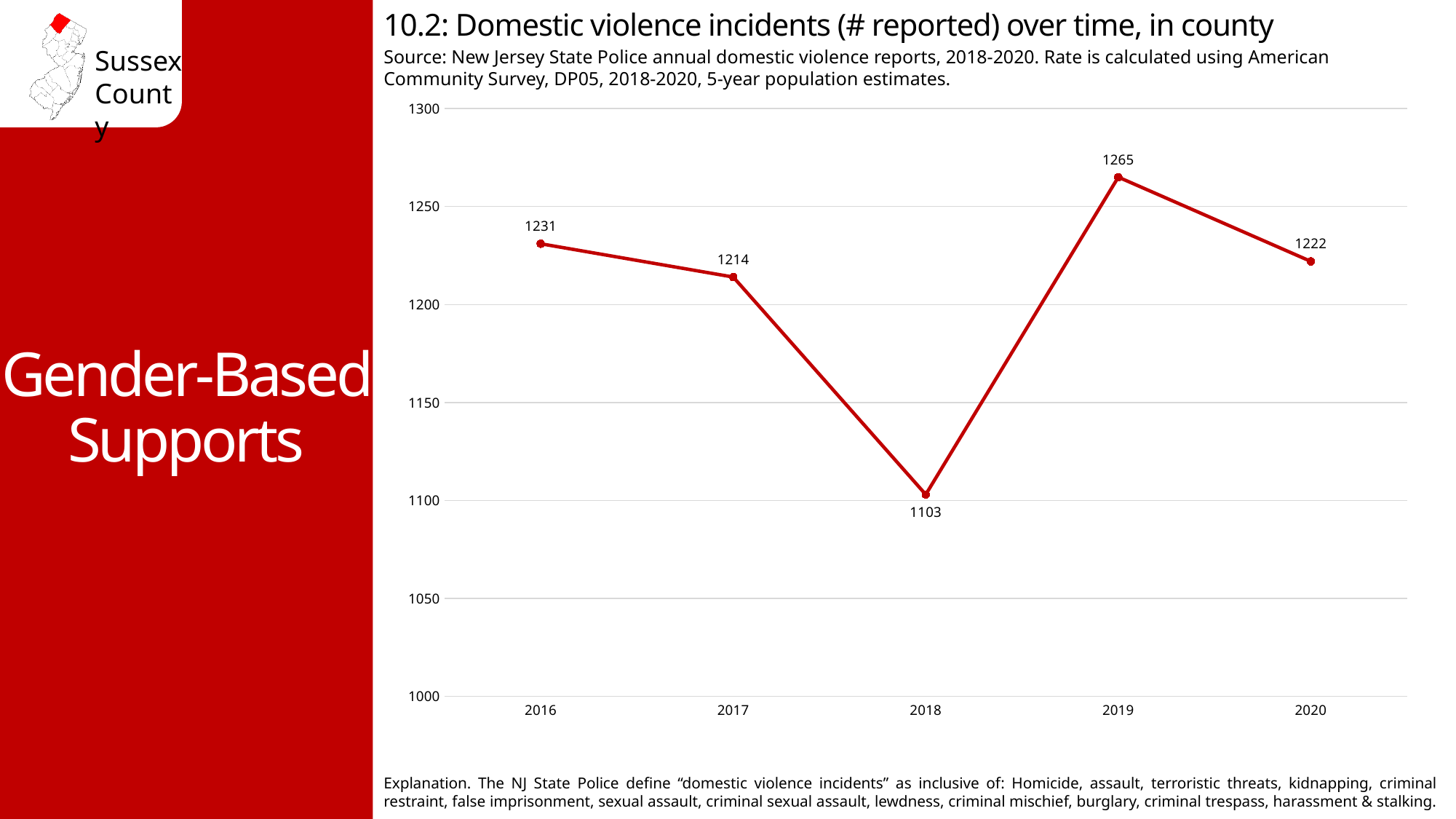
What is the difference between the number of incidents in 2016 and in 2017? 17 Is the value for 2018 greater or less than 1150? less Which year had the highest number of reported domestic violence incidents? 2019 What was the number of reported domestic violence incidents in 2018? 1103 What was the number of reported domestic violence incidents in 2016? 1231 How many years are plotted on the chart? 5 What is the difference between the number of incidents in 2019 and in 2018? 162 Which year had more reported incidents, 2017 or 2020? 2020 What kind of chart is shown on the slide? line chart Did the number of reported incidents rise or fall from 2019 to 2020? fall Which year had the lowest number of reported domestic violence incidents? 2018 What was the number of reported domestic violence incidents in 2020? 1222